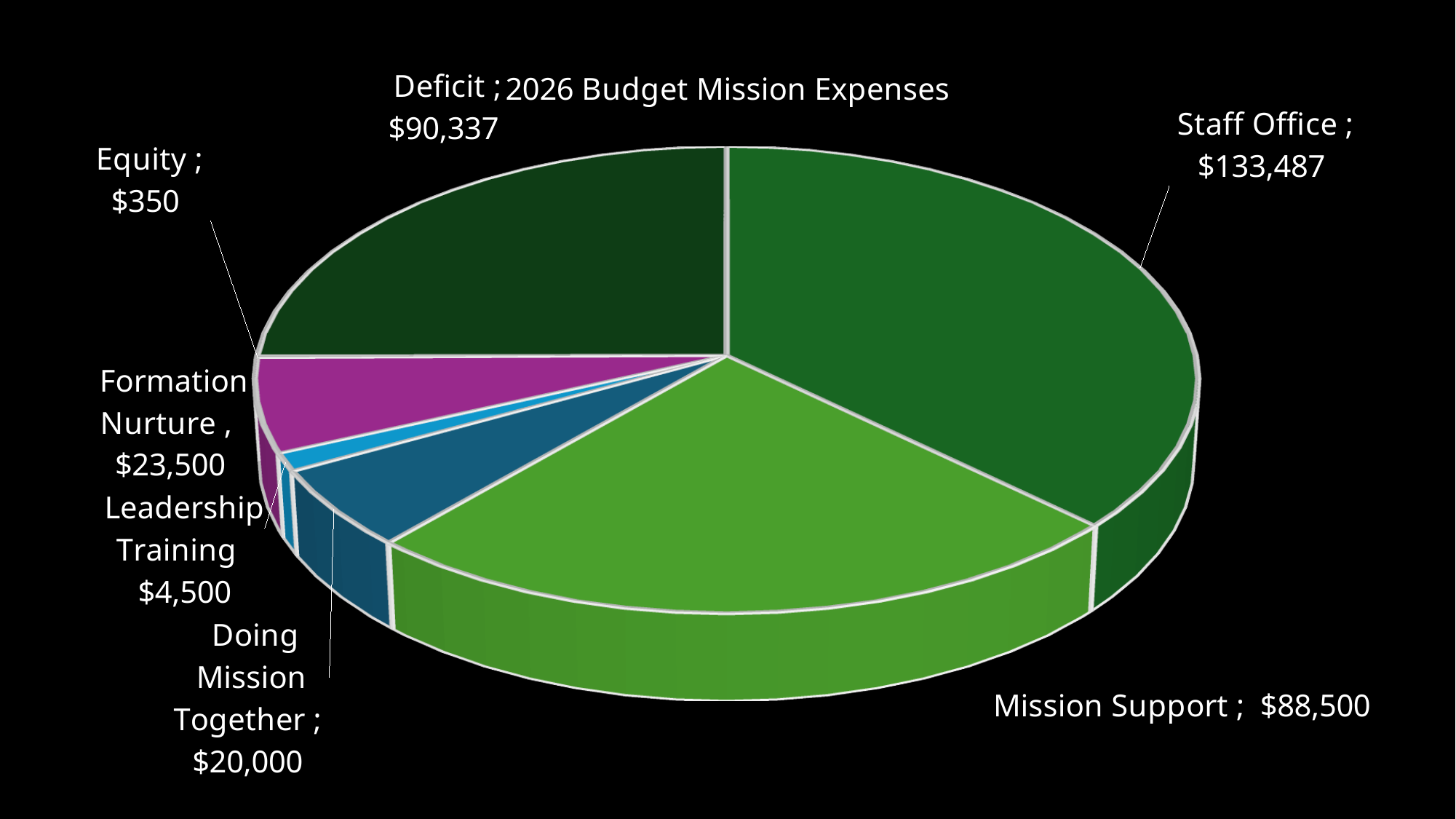
What is the value for Deficit? $90,337 How many slices does the pie chart have? 7 Which category has the largest slice of the pie? Staff Office What is the value for Formation Nurture? $23,500 Which category has the smallest slice of the pie? Equity What is the difference between Staff Office and Mission Support? $44,987 What is the value for Staff Office? $133,487 What is the title of the pie chart? 2026 Budget Mission Expenses Which is larger, Formation Nurture or Doing Mission Together? Formation Nurture What is the value for Mission Support? $88,500 What kind of chart is shown on the slide? Pie chart What is the value for Equity? $350